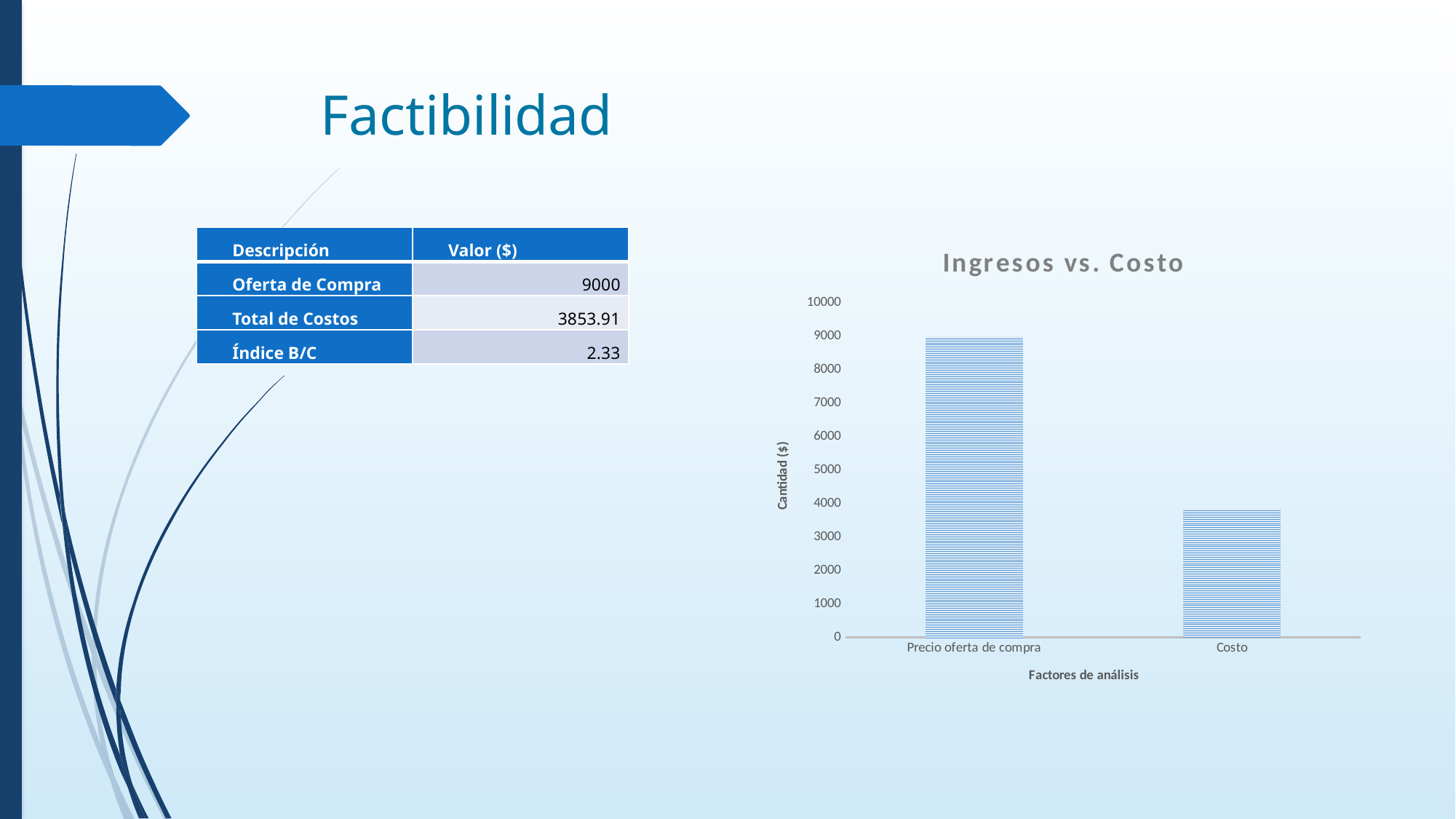
What is the title of the chart? Ingresos vs. Costo Is the value for Precio oferta de compra greater or less than 10000? less Is the value for Precio oferta de compra greater or less than 8000? greater How many bars are plotted in the chart? 2 Which is larger in the chart, Precio oferta de compra or Costo? Precio oferta de compra What is the label of the vertical axis of the chart? Cantidad ($) Which category has the highest bar in the chart? Precio oferta de compra Do the bar values rise or fall from left to right along the x axis? fall What type of chart is shown on the slide? bar chart Is the value for Costo greater or less than 4000? less Which category has the lowest bar in the chart? Costo